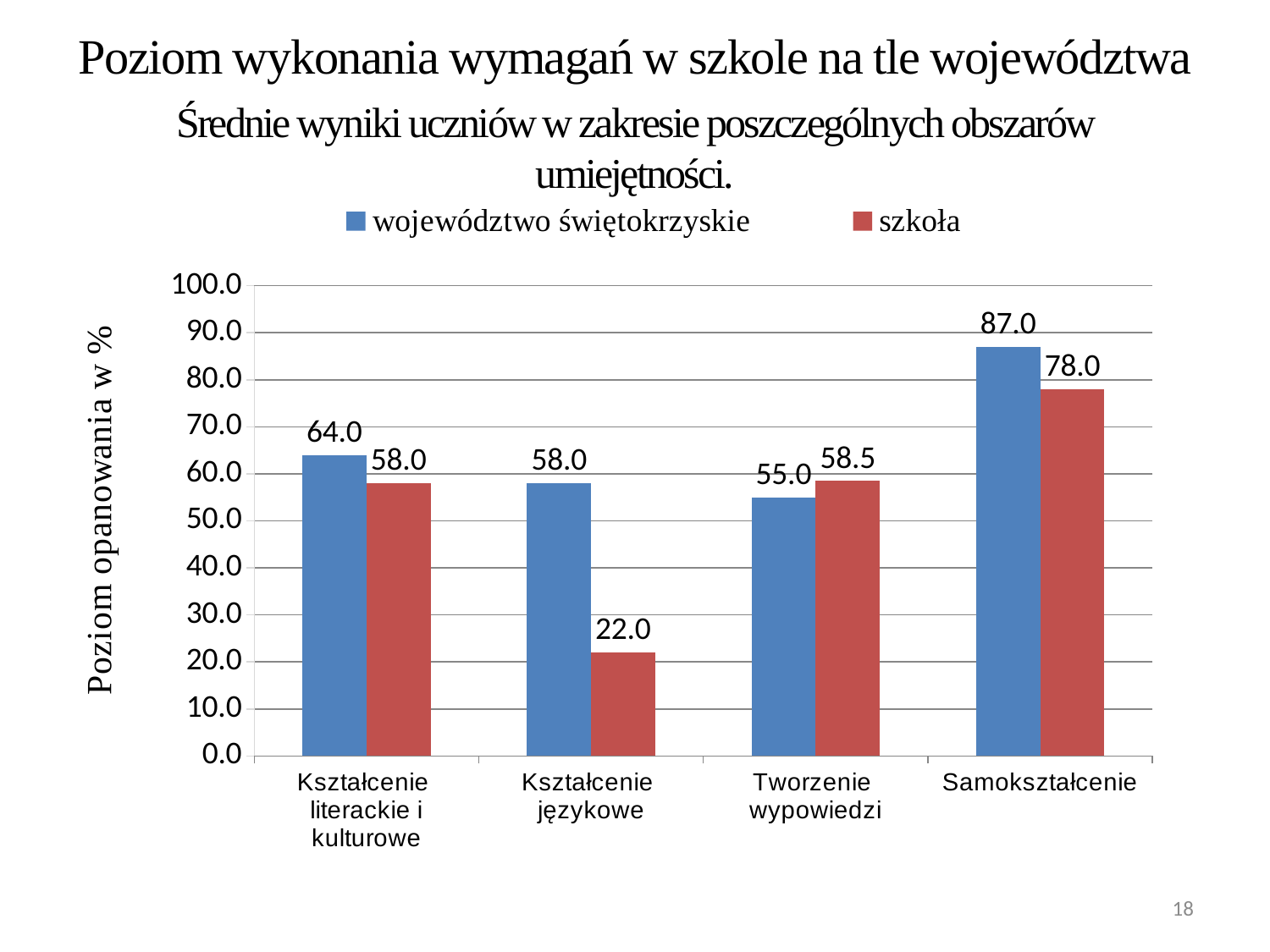
What is the value for 'szkoła' in the 'Kształcenie językowe' category? 22.0 What is the difference between 'województwo świętokrzyskie' and 'szkoła' in the 'Kształcenie językowe' category? 36.0 Is the value for 'szkoła' in 'Samokształcenie' greater or less than 70.0? greater What is the label of the y axis? Poziom opanowania w % What is the value for 'szkoła' in the 'Tworzenie wypowiedzi' category? 58.5 What kind of chart is shown on the slide? bar chart What is the value for 'województwo świętokrzyskie' in the 'Samokształcenie' category? 87.0 How many series does the legend list? 2 Which category has the highest value for 'szkoła'? Samokształcenie Which category has the lowest value for 'województwo świętokrzyskie'? Tworzenie wypowiedzi In the 'Tworzenie wypowiedzi' category, which series has the larger value, 'województwo świętokrzyskie' or 'szkoła'? szkoła How many categories are shown on the x axis? 4